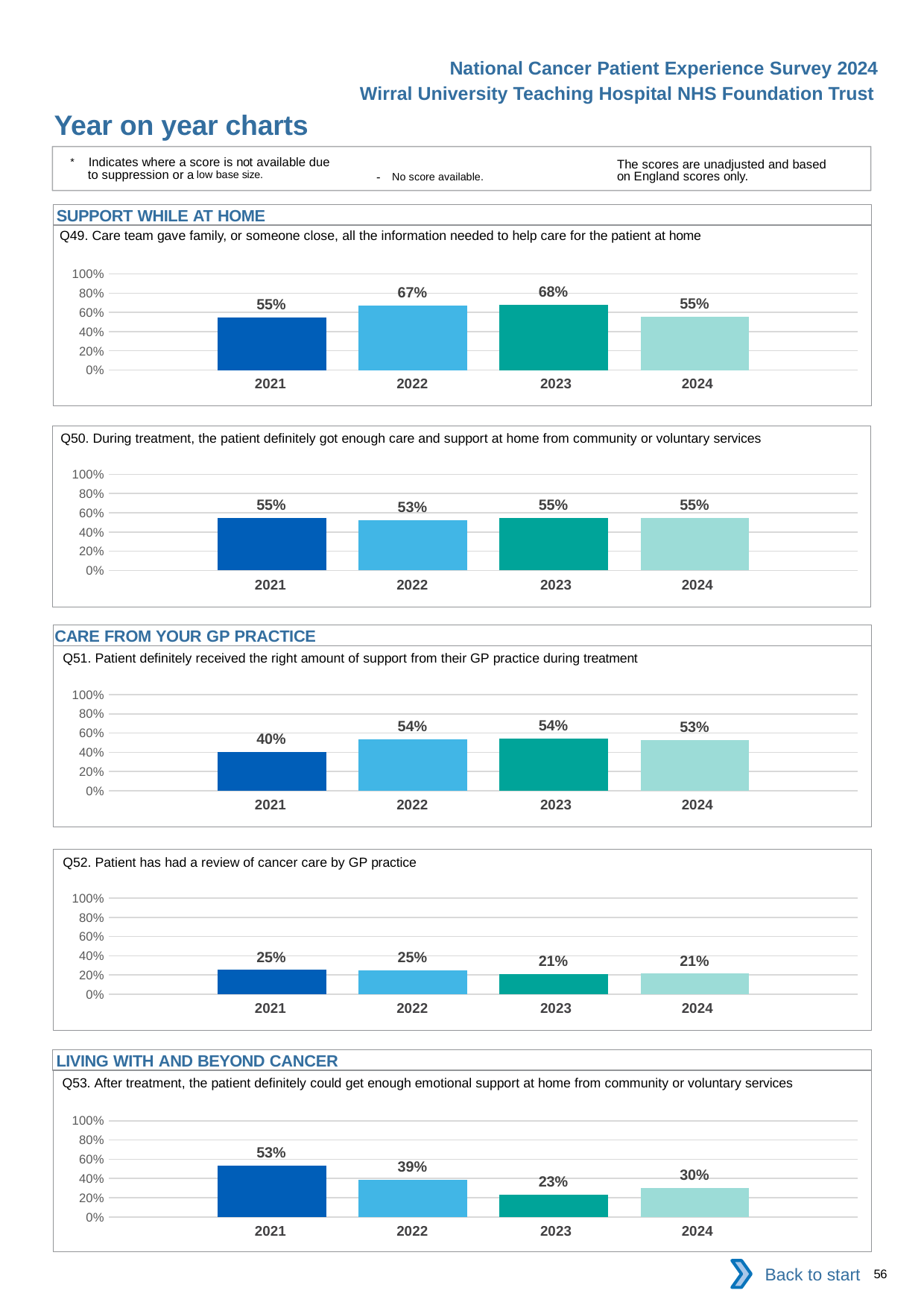
In the Q49 chart, which year has the lowest value? 2021 and 2024 (both 55%) In the Q51 chart, what is the difference between the 2022 value and the 2021 value? 14 percentage points What type of chart is used for Q52? bar chart In the Q53 chart, do the values rise or fall from 2021 to 2023? fall In the Q52 chart, is the value for 2021 larger or smaller than the value for 2023? larger In the Q53 chart, what is the difference between the 2021 value and the 2023 value? 30 percentage points In the Q49 chart, what is the value for 2023? 68% In the Q53 chart, which year has the highest value? 2021 How many years are plotted in the Q50 chart? 4 In the Q51 chart, which year has the lowest value? 2021 In the Q52 chart, what is the value for 2024? 21% In the Q50 chart, what is the value for 2022? 53%